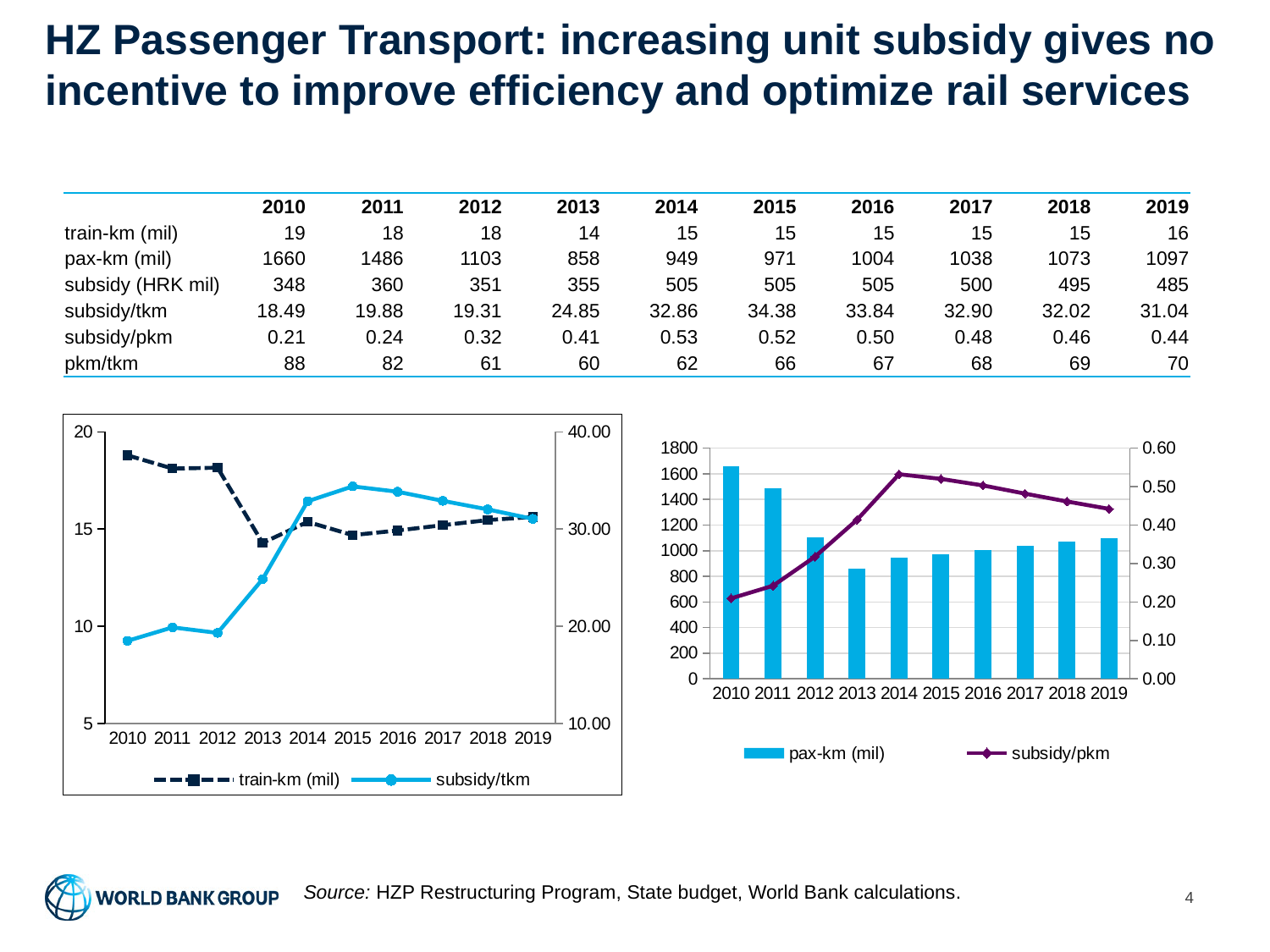
In the right chart, which year has the lowest pax-km (mil)? 2013 How many series does the legend of the right chart list? 2 What kind of chart is the chart on the left of the slide? line chart How many years are shown on the x axis of the left chart? 10 In the left chart, is the value for train-km (mil) in 2010 greater or less than 15? greater In the right chart, does subsidy/pkm rise or fall from 2014 to 2019? fall In the right chart, which year has the highest pax-km (mil)? 2010 What kind of chart is the chart on the right of the slide? combined bar and line chart In the right chart, what is the value of pax-km (mil) in 2019? 1097 In the right chart, is the value for pax-km (mil) in 2013 greater or less than 1000? less In the left chart, is the value for subsidy/tkm in 2015 greater or less than 30.00? greater In the right chart, what is the difference between pax-km (mil) in 2010 and in 2019? 563